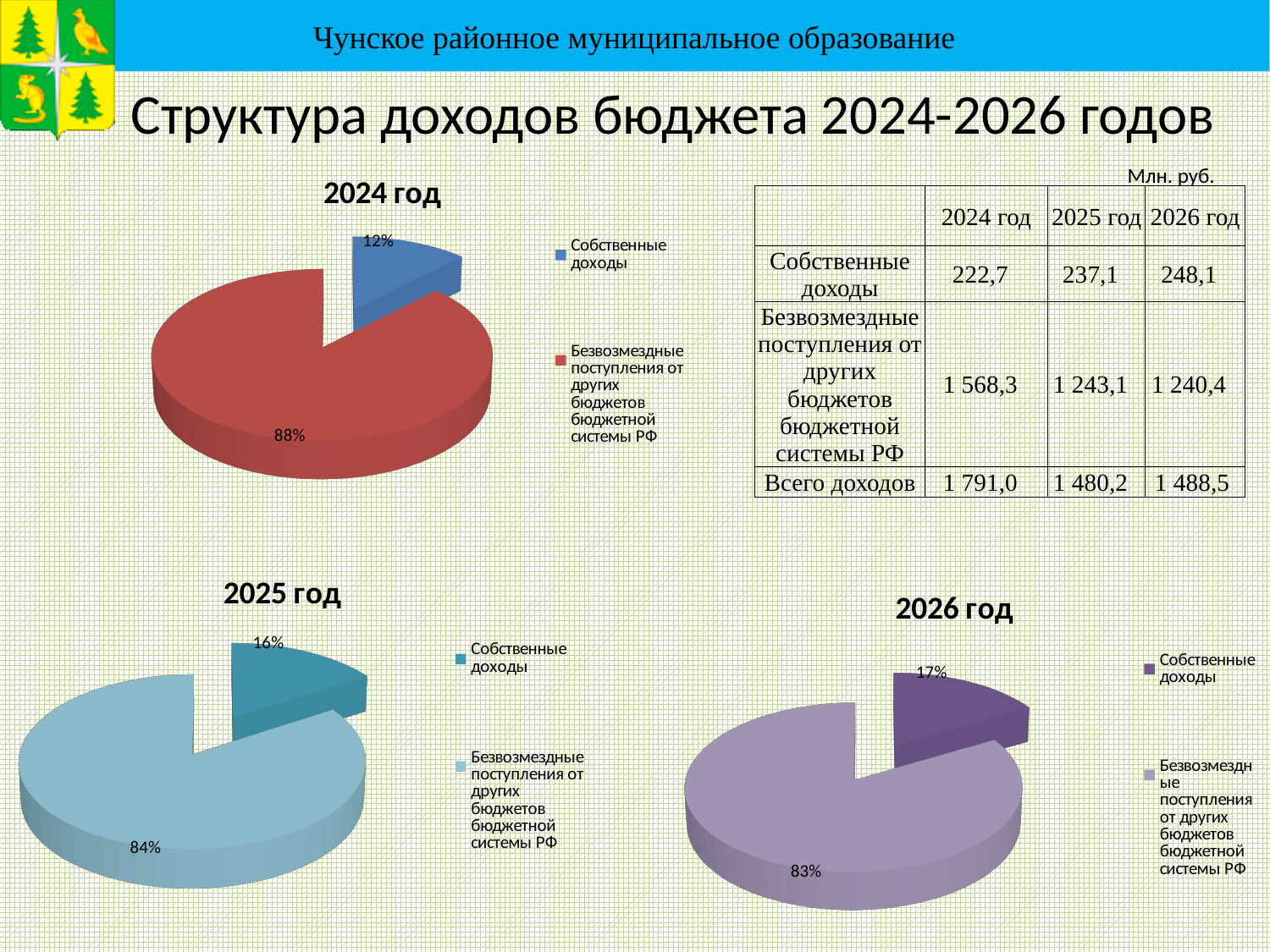
In the "2024 год" chart, what share of the pie is "Безвозмездные поступления от других бюджетов бюджетной системы РФ"? 88% In the "2026 год" chart, which category has the smallest slice? Собственные доходы In the "2024 год" chart, what share of the pie is "Собственные доходы"? 12% In the "2026 год" chart, what share of the pie is "Безвозмездные поступления от других бюджетов бюджетной системы РФ"? 83% How many slices does the "2025 год" chart have? 2 How many entries does the legend of the "2026 год" chart list? 2 In the "2025 год" chart, what is the difference in percentage points between the two slices? 68 What kind of chart is the "2024 год" chart? Pie chart In the "2024 год" chart, which category has the largest slice? Безвозмездные поступления от других бюджетов бюджетной системы РФ